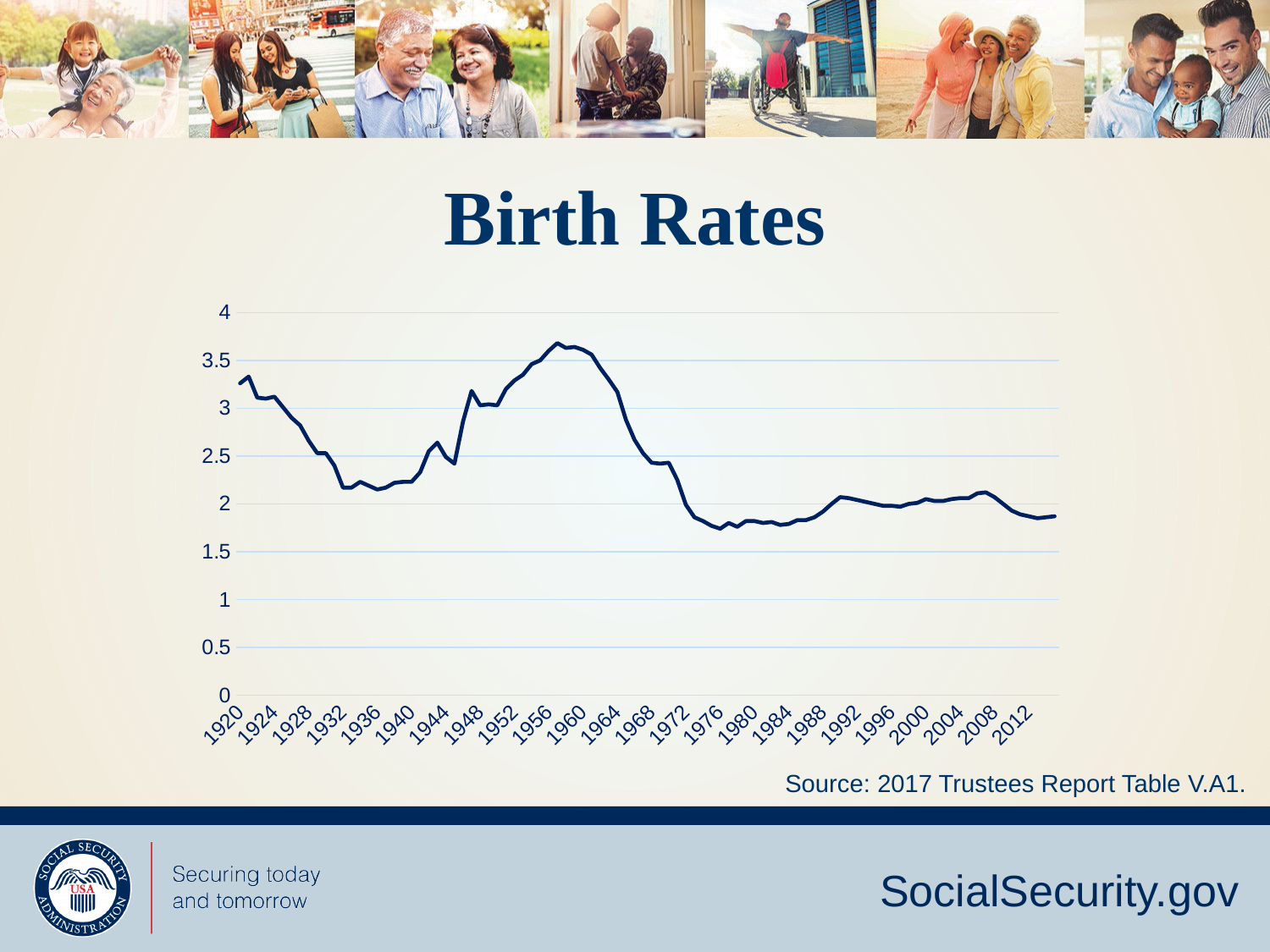
Is the birth rate value for 1960 greater or less than 3.5? greater What is the title of the chart? Birth Rates Is the birth rate value for 2012 greater or less than 2? less Is the birth rate value for 1976 greater or less than 2? less What is the highest value shown on the vertical axis? 4 What kind of chart is shown on the slide? line chart Does the line reach its highest point before or after 1970? before Does the birth rate rise or fall between 1936 and 1948? rise Does the birth rate rise or fall between 1960 and 1976? fall